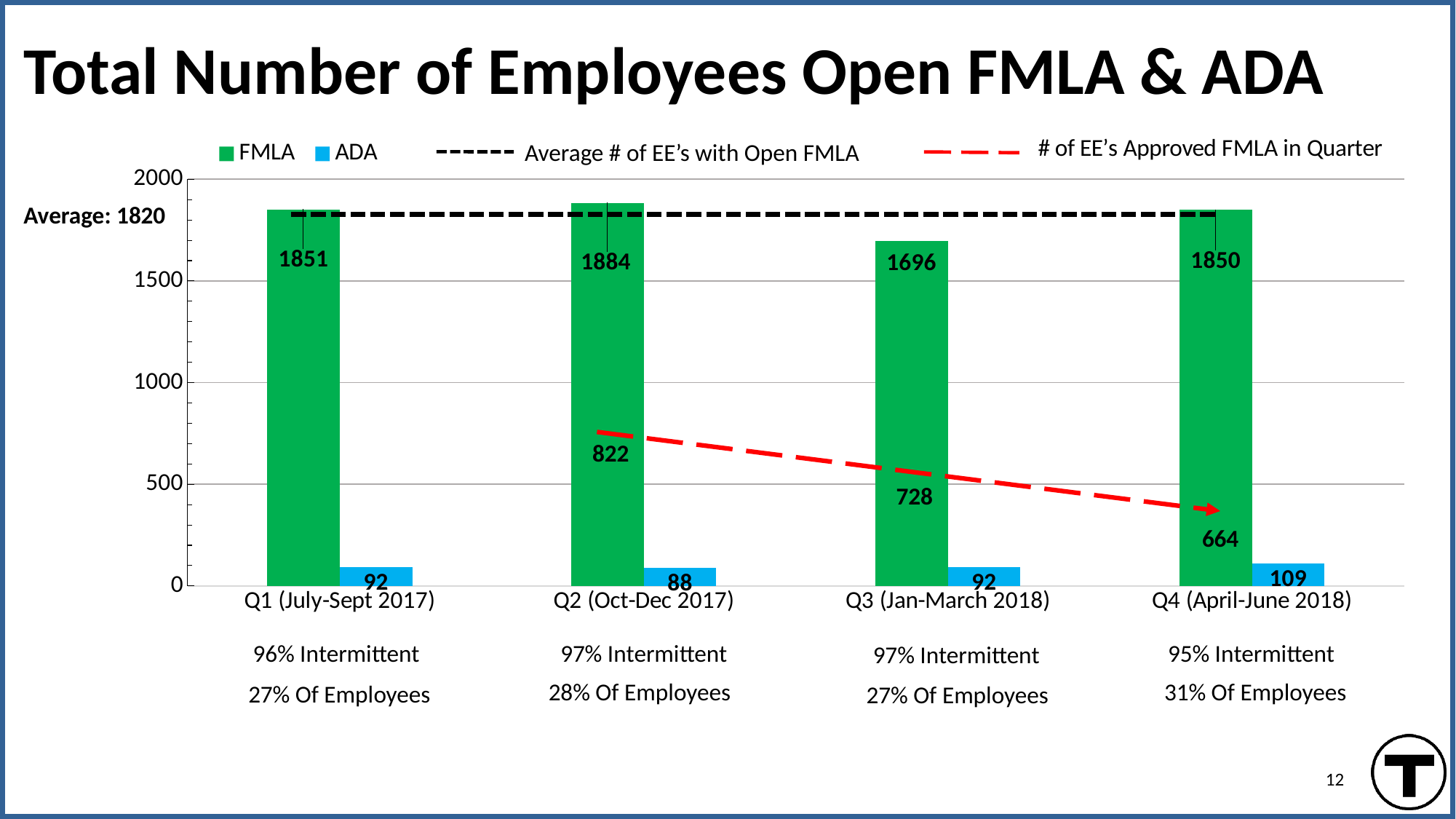
Which quarter has the highest FMLA value? Q2 (Oct-Dec 2017) What is the ADA value for Q4 (April-June 2018)? 109 Do the values for # of EE's Approved FMLA in Quarter rise or fall from Q2 to Q4? fall How many quarters are shown on the x axis? 4 Which is larger, the ADA value for Q4 (April-June 2018) or the ADA value for Q2 (Oct-Dec 2017)? Q4 (April-June 2018) Which quarter has the lowest FMLA value? Q3 (Jan-March 2018) How many entries does the legend list? 4 What kind of chart is shown on the slide? bar chart What is the difference between the FMLA values for Q2 (Oct-Dec 2017) and Q3 (Jan-March 2018)? 188 What is the FMLA value for Q2 (Oct-Dec 2017)? 1884 Is the FMLA value for Q3 (Jan-March 2018) greater or less than 1500? greater What is the value of the Average # of EE's with Open FMLA line? 1820